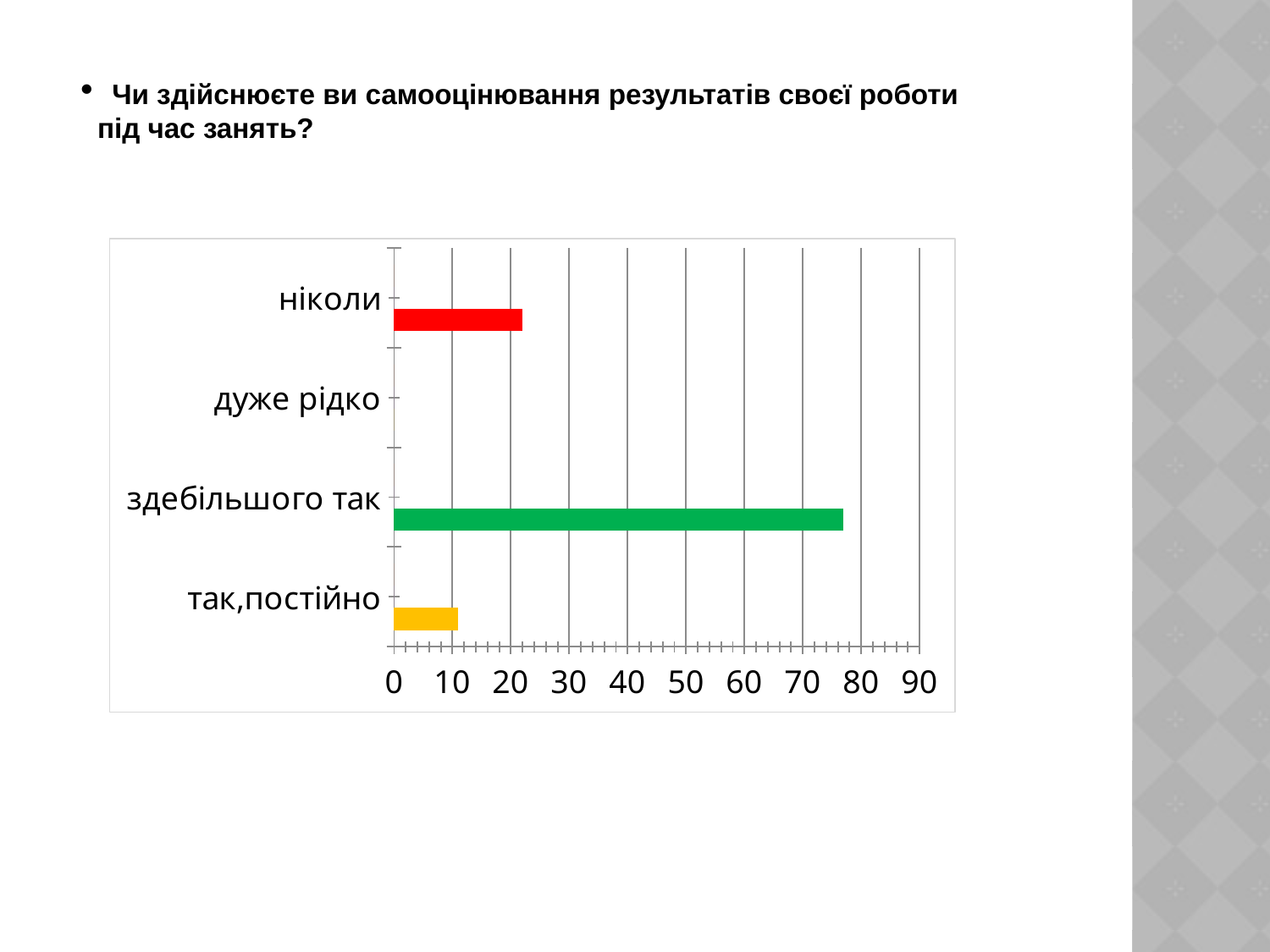
Which category has the highest value in the chart? здебільшого так What kind of chart is shown on the slide? bar chart Is the value for ніколи greater or less than 30? less Which is larger, the value for ніколи or the value for так,постійно? ніколи Which category has no visible bar in the chart? дуже рідко Is the value for так,постійно greater or less than 20? less Is the value for здебільшого так greater or less than 80? less How many categories are shown on the vertical axis of the chart? 4 What is the highest tick value shown on the horizontal axis of the chart? 90 Which is larger, the value for здебільшого так or the value for ніколи? здебільшого так What colour is the bar for здебільшого так? green